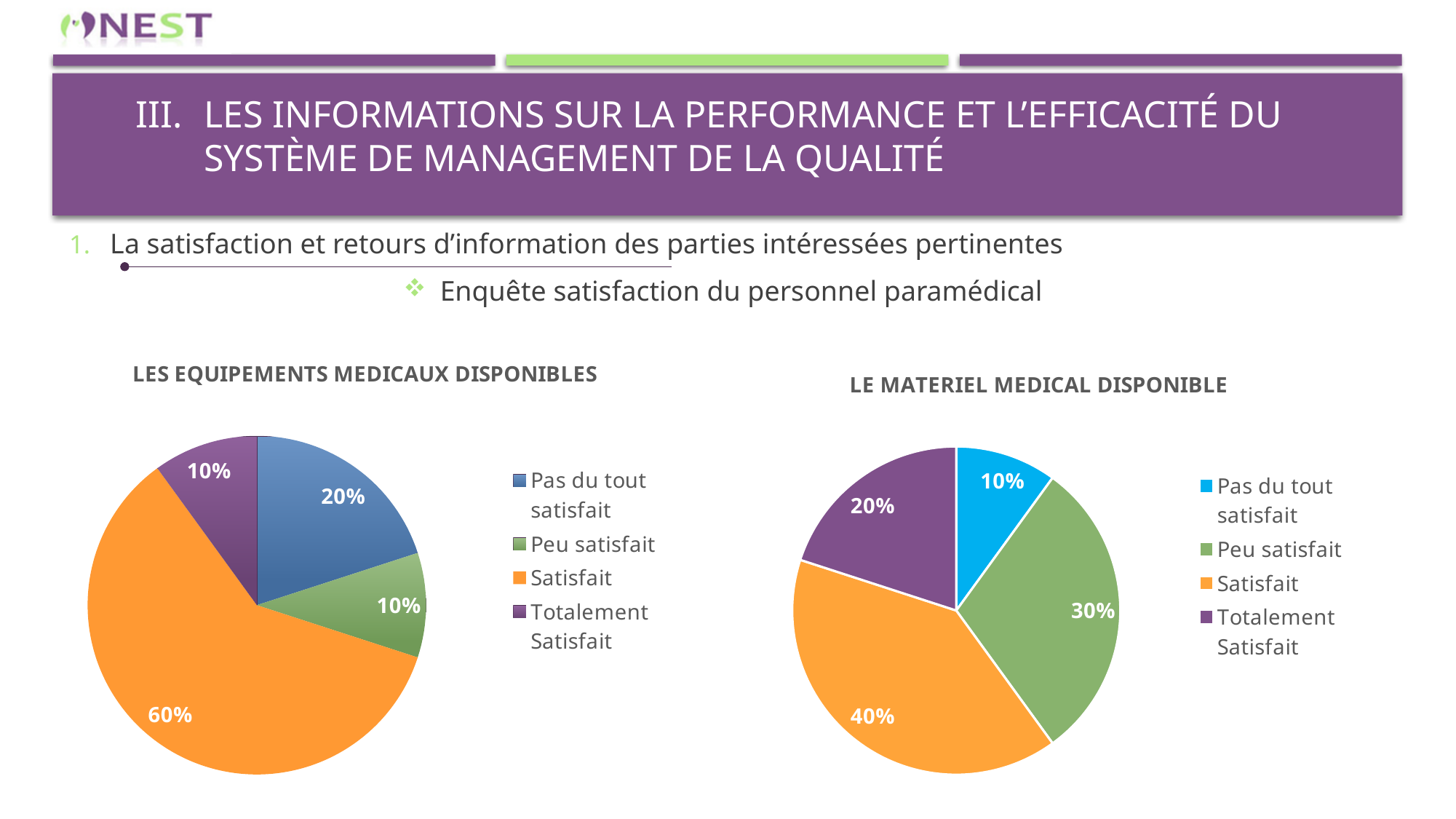
How many categories does the legend of the chart titled "LE MATERIEL MEDICAL DISPONIBLE" list? 4 In the chart titled "LES EQUIPEMENTS MEDICAUX DISPONIBLES", which is larger: Pas du tout satisfait or Totalement Satisfait? Pas du tout satisfait In the chart titled "LE MATERIEL MEDICAL DISPONIBLE", which category has the smallest slice? Pas du tout satisfait In the chart titled "LE MATERIEL MEDICAL DISPONIBLE", what share is labelled for Peu satisfait? 30% In the chart titled "LES EQUIPEMENTS MEDICAUX DISPONIBLES", what share is labelled for Satisfait? 60% In the chart titled "LE MATERIEL MEDICAL DISPONIBLE", what colour is the Satisfait slice? Orange In the chart titled "LE MATERIEL MEDICAL DISPONIBLE", what is the difference between the Satisfait and Peu satisfait shares? 10% What kind of chart is the chart titled "LES EQUIPEMENTS MEDICAUX DISPONIBLES"? Pie chart In the chart titled "LES EQUIPEMENTS MEDICAUX DISPONIBLES", which category has the largest slice? Satisfait In the chart titled "LES EQUIPEMENTS MEDICAUX DISPONIBLES", what share is labelled for Pas du tout satisfait? 20% In the chart titled "LE MATERIEL MEDICAL DISPONIBLE", what share is labelled for Totalement Satisfait? 20% What is the title of the pie chart on the right side of the slide? LE MATERIEL MEDICAL DISPONIBLE